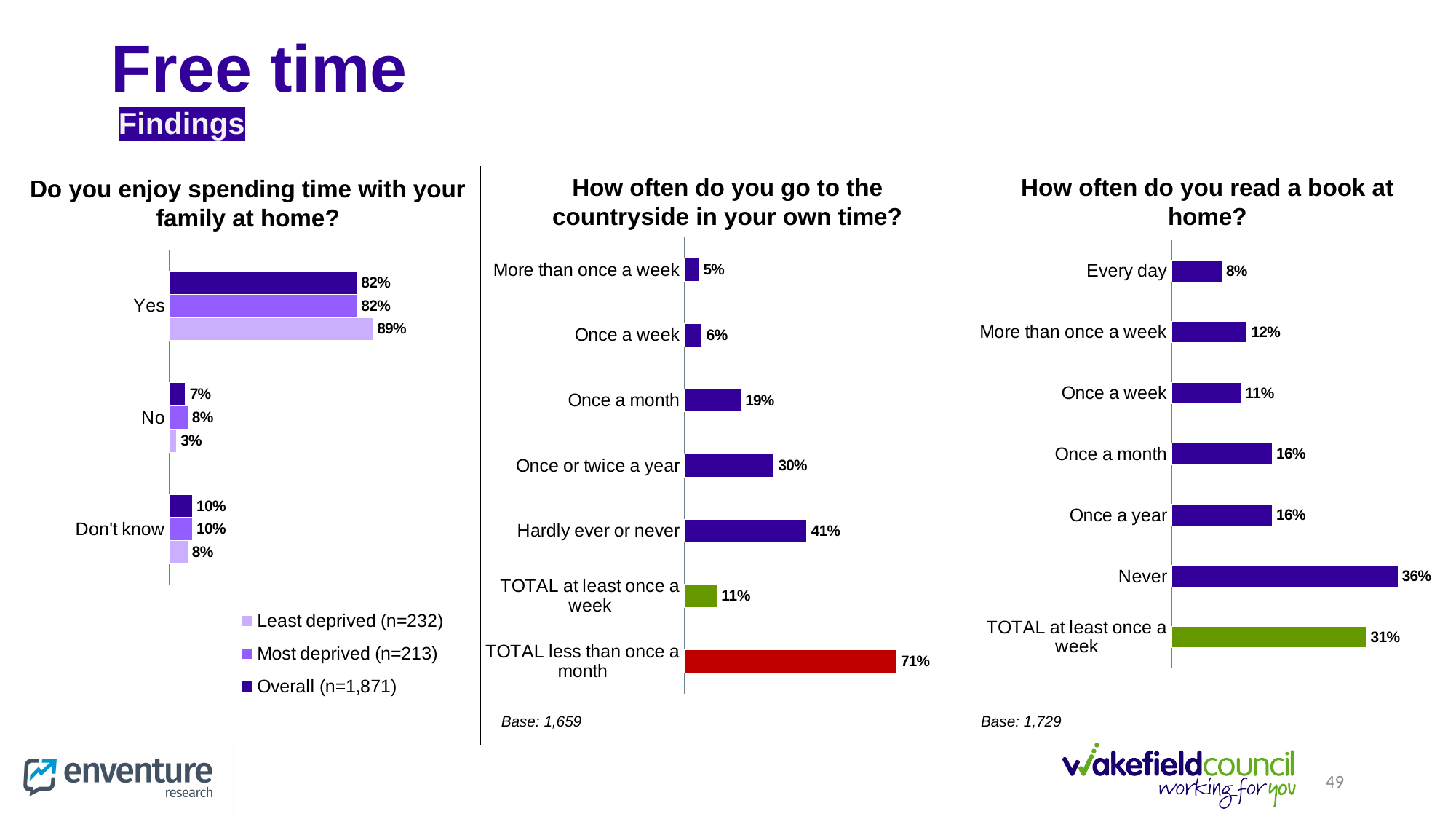
In the chart 'How often do you go to the countryside in your own time?', which of the five frequency categories (excluding the TOTAL bars) has the lowest value? More than once a week In the chart 'How often do you go to the countryside in your own time?', what is the value for 'TOTAL less than once a month'? 71% In the chart 'How often do you read a book at home?', what is the value for 'Every day'? 8% In the chart 'Do you enjoy spending time with your family at home?', what is the value for 'Yes' among the Least deprived group? 89% In the chart 'How often do you go to the countryside in your own time?', what is the value for 'Hardly ever or never'? 41% In the chart 'How often do you go to the countryside in your own time?', what is the difference between 'Once or twice a year' and 'Once a month'? 11% What type of chart is 'How often do you read a book at home?'? Bar chart In the chart 'Do you enjoy spending time with your family at home?', how many series does the legend list? 3 In the chart 'How often do you read a book at home?', which is larger: 'More than once a week' or 'Once a week'? More than once a week In the chart 'Do you enjoy spending time with your family at home?', what is the Overall value for 'No'? 7% In the chart 'How often do you read a book at home?', which category has the highest value? Never In the chart 'Do you enjoy spending time with your family at home?', what is the difference between the Least deprived and Most deprived values for 'No'? 5%